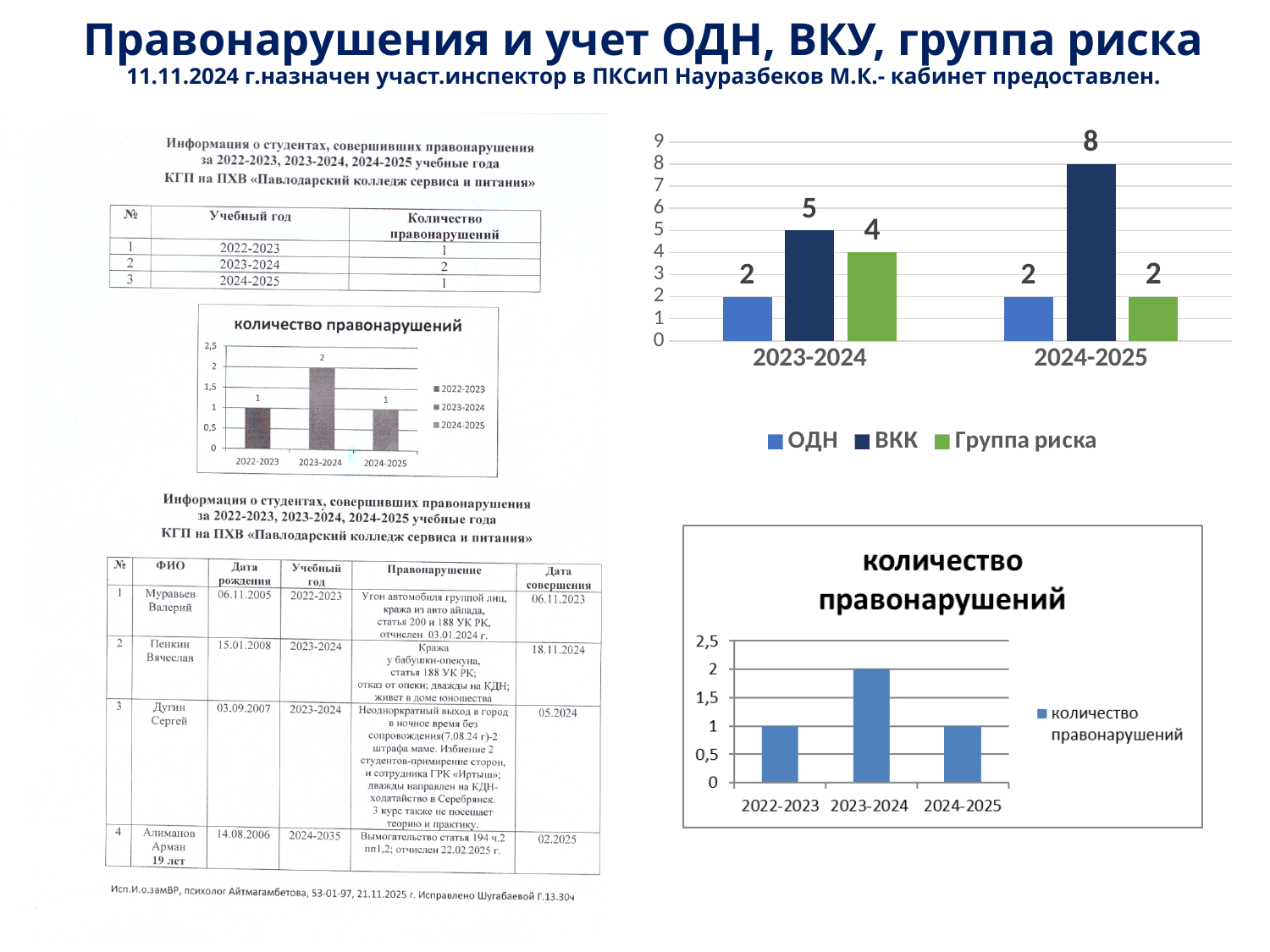
What kind of chart is the chart titled 'количество правонарушений' at the bottom right? bar chart In the top-right bar chart, what is the value for Группа риска in 2023-2024? 4 How many series does the legend of the top-right bar chart list? 3 How many categories are shown on the x axis of the chart titled 'количество правонарушений' at the bottom right? 3 In the top-right bar chart, which is larger: ВКК in 2023-2024 or Группа риска in 2023-2024? ВКК in 2023-2024 In the top-right bar chart, what is the difference between the ВКК values for 2024-2025 and 2023-2024? 3 In the chart titled 'количество правонарушений' at the bottom right, what is the value for 2023-2024? 2 In the top-right bar chart, what colour are the ВКК bars? dark blue In the top-right bar chart, what is the value for ВКК in 2024-2025? 8 In the top-right bar chart, which series has the highest value in 2024-2025? ВКК In the top-right bar chart, what is the value for ОДН in 2023-2024? 2 In the chart titled 'количество правонарушений' at the bottom right, which academic year has the highest value? 2023-2024